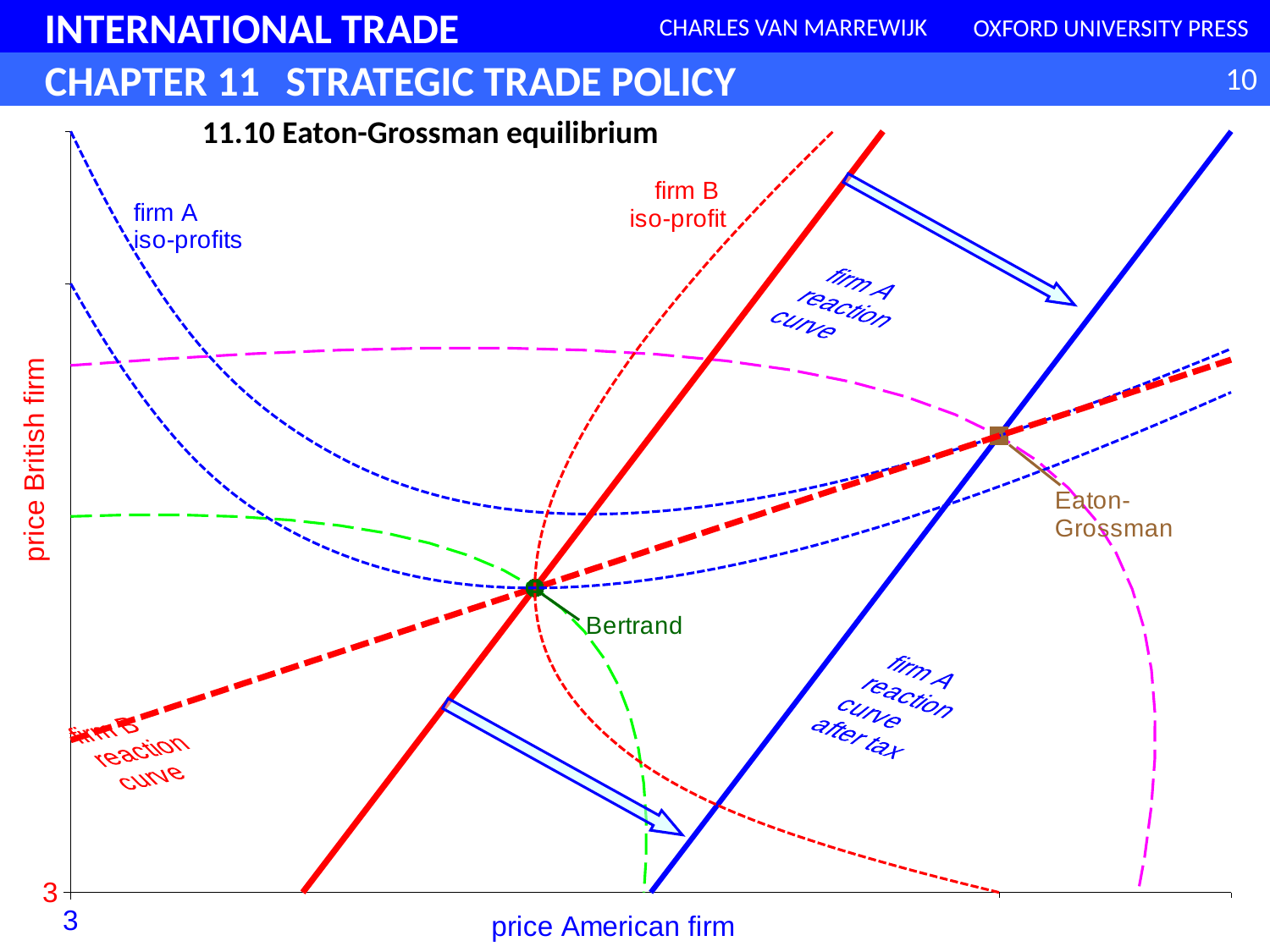
Which equilibrium point lies on the firm A reaction curve after tax? Eaton-Grossman What is the label of the horizontal axis? price American firm Does the firm A reaction curve rise or fall as the price of the American firm increases? rise What value is marked at the origin of the horizontal axis? 3 Which equilibrium point has the lower price for the American firm, Bertrand or Eaton-Grossman? Bertrand What is the title of the chart? 11.10 Eaton-Grossman equilibrium How many labelled equilibrium points are marked on the chart? 2 Does the firm B reaction curve rise or fall as the price of the American firm increases? rise What value is marked at the origin of the vertical axis (price British firm)? 3 What kind of chart is shown on the slide? line chart Which equilibrium point has the higher price for the British firm, Bertrand or Eaton-Grossman? Eaton-Grossman